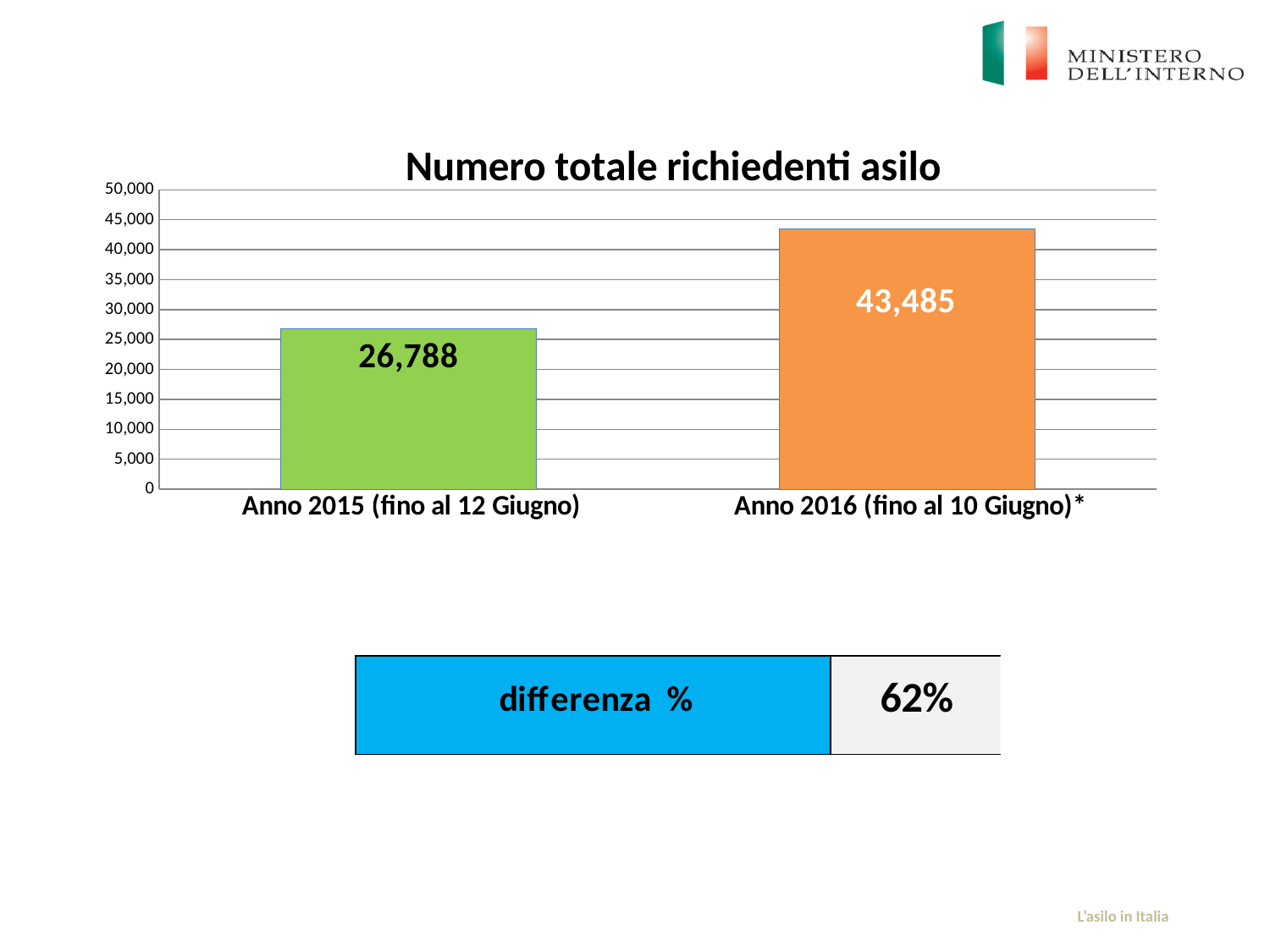
Is the value for Anno 2016 (fino al 10 Giugno)* greater or less than 40,000? greater Which category has the lowest value? Anno 2015 (fino al 12 Giugno) How many categories are shown in the chart? 2 Do the values rise or fall from Anno 2015 to Anno 2016? rise What is the difference between the values for Anno 2016 (fino al 10 Giugno)* and Anno 2015 (fino al 12 Giugno)? 16,697 Which is larger, the value for Anno 2015 (fino al 12 Giugno) or Anno 2016 (fino al 10 Giugno)*? Anno 2016 (fino al 10 Giugno)* Is the value for Anno 2015 (fino al 12 Giugno) greater or less than 30,000? less Which category has the highest value? Anno 2016 (fino al 10 Giugno)* What is the value for Anno 2015 (fino al 12 Giugno)? 26,788 What is the title of the chart? Numero totale richiedenti asilo What kind of chart is shown on the slide? bar chart What is the value for Anno 2016 (fino al 10 Giugno)*? 43,485